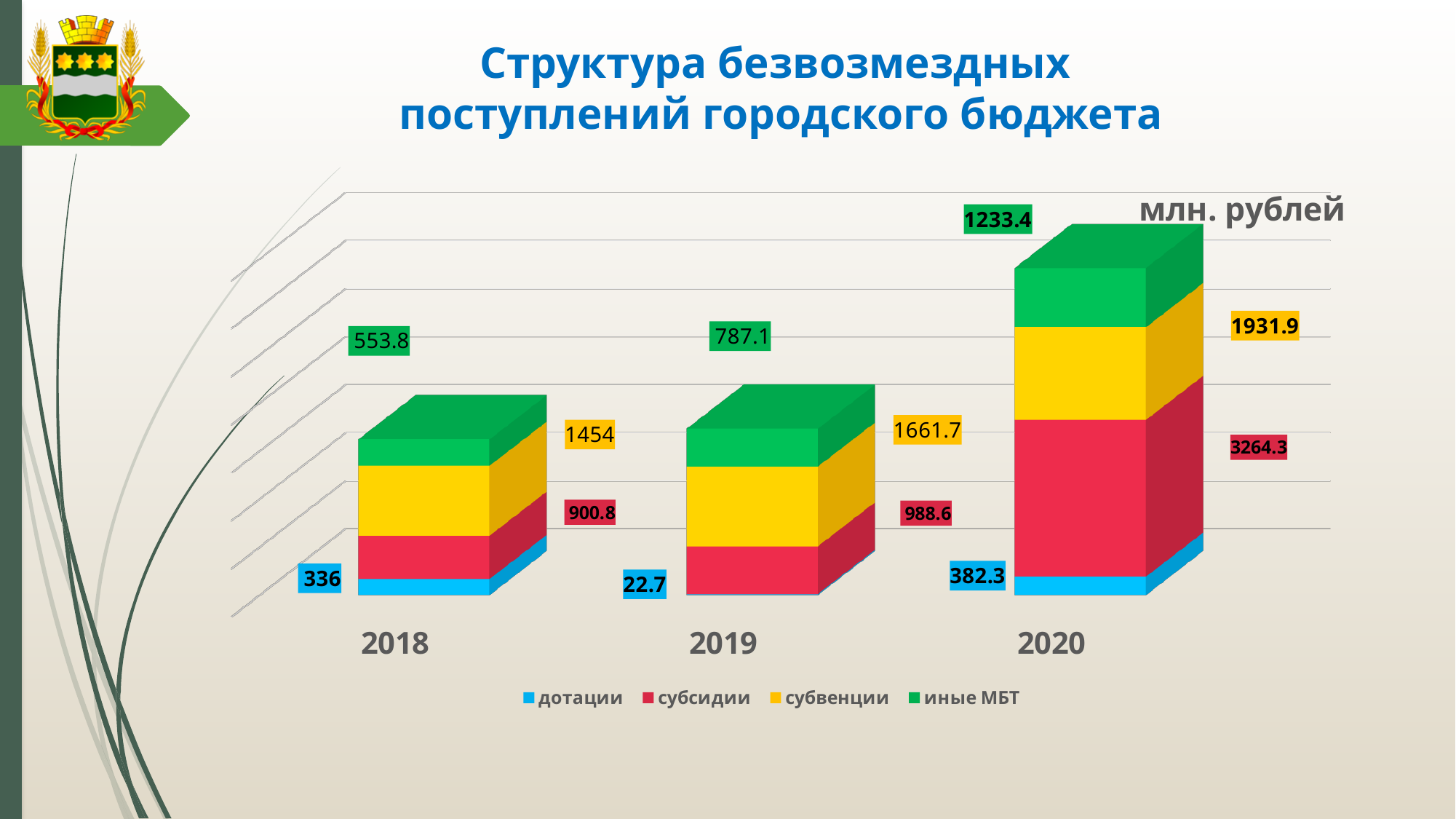
What is the difference between субвенции in 2020 and субвенции in 2019? 270.2 In which year is the value for иные МБТ the highest? 2020 What is the value for субвенции in 2018? 1454 In which year is the value for дотации the lowest? 2019 What is the value for дотации in 2019? 22.7 How many years are shown on the x axis? 3 What is the value for субсидии in 2020? 3264.3 Which is larger in 2018: субсидии or субвенции? субвенции What is the value for иные МБТ in 2019? 787.1 How many series does the legend list? 4 What is the total of the stacked bar for 2020? 6811.9 What kind of chart is shown on the slide? stacked bar chart